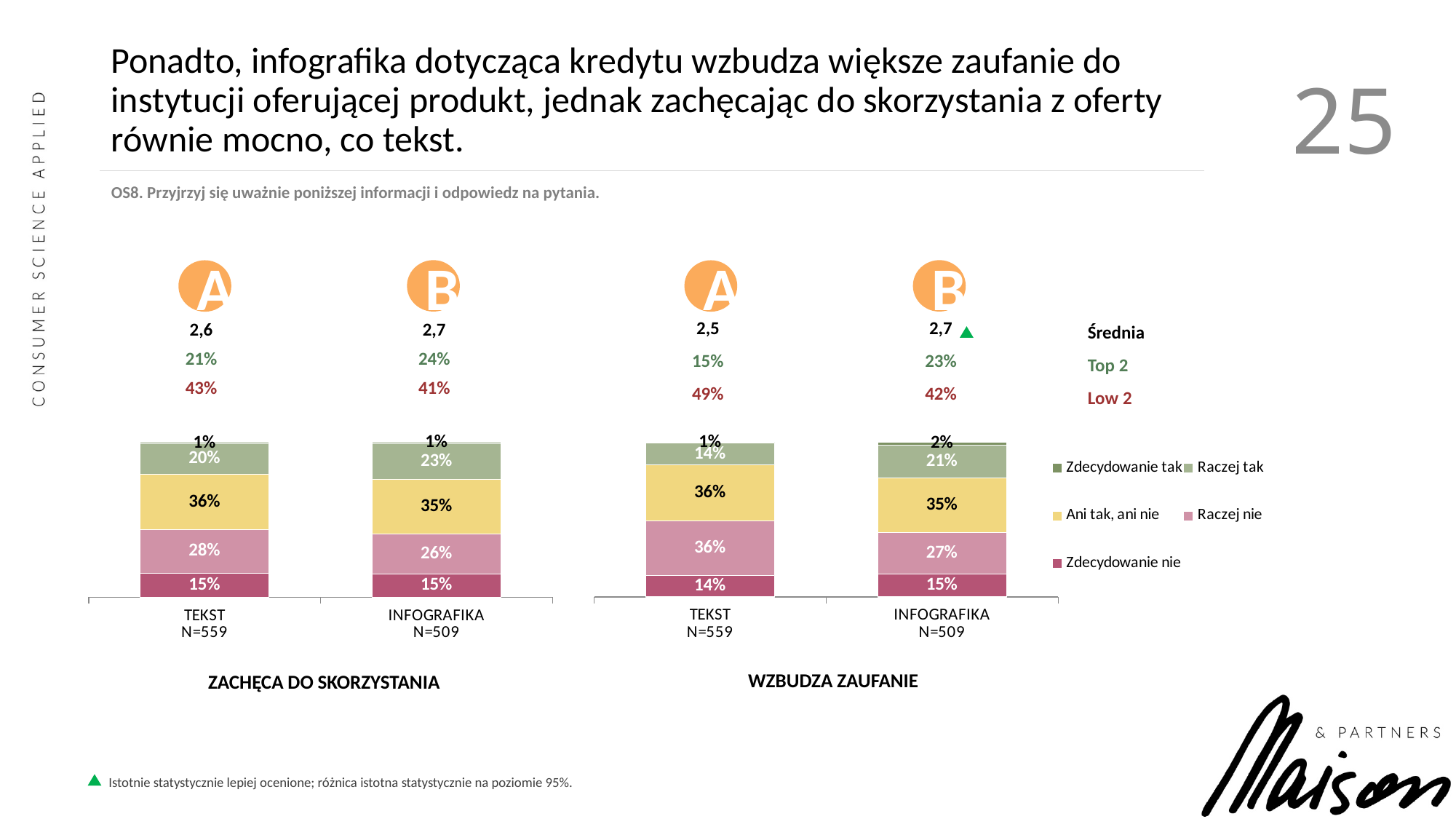
In the ZACHĘCA DO SKORZYSTANIA chart, which segment of the TEKST bar is the largest? Ani tak, ani nie In the ZACHĘCA DO SKORZYSTANIA chart, what is the 'Ani tak, ani nie' value for TEKST? 36% In the WZBUDZA ZAUFANIE chart, what is the mean (Średnia) shown for TEKST? 2,5 In the WZBUDZA ZAUFANIE chart, what is the 'Raczej nie' value for TEKST? 36% In the WZBUDZA ZAUFANIE chart, which has the higher 'Raczej tak' value, TEKST or INFOGRAFIKA? INFOGRAFIKA How many series does the legend list? 5 In the ZACHĘCA DO SKORZYSTANIA chart, what is the Low 2 value shown for TEKST? 43% In the ZACHĘCA DO SKORZYSTANIA chart, what is the 'Raczej tak' value for INFOGRAFIKA? 23% In the WZBUDZA ZAUFANIE chart, what is the difference between the 'Raczej nie' values for TEKST and INFOGRAFIKA? 9% In the WZBUDZA ZAUFANIE chart, what is the Top 2 value shown for INFOGRAFIKA? 23% What kind of chart is the WZBUDZA ZAUFANIE chart? Stacked bar chart In the WZBUDZA ZAUFANIE chart, what is the 'Zdecydowanie tak' value for INFOGRAFIKA? 2%